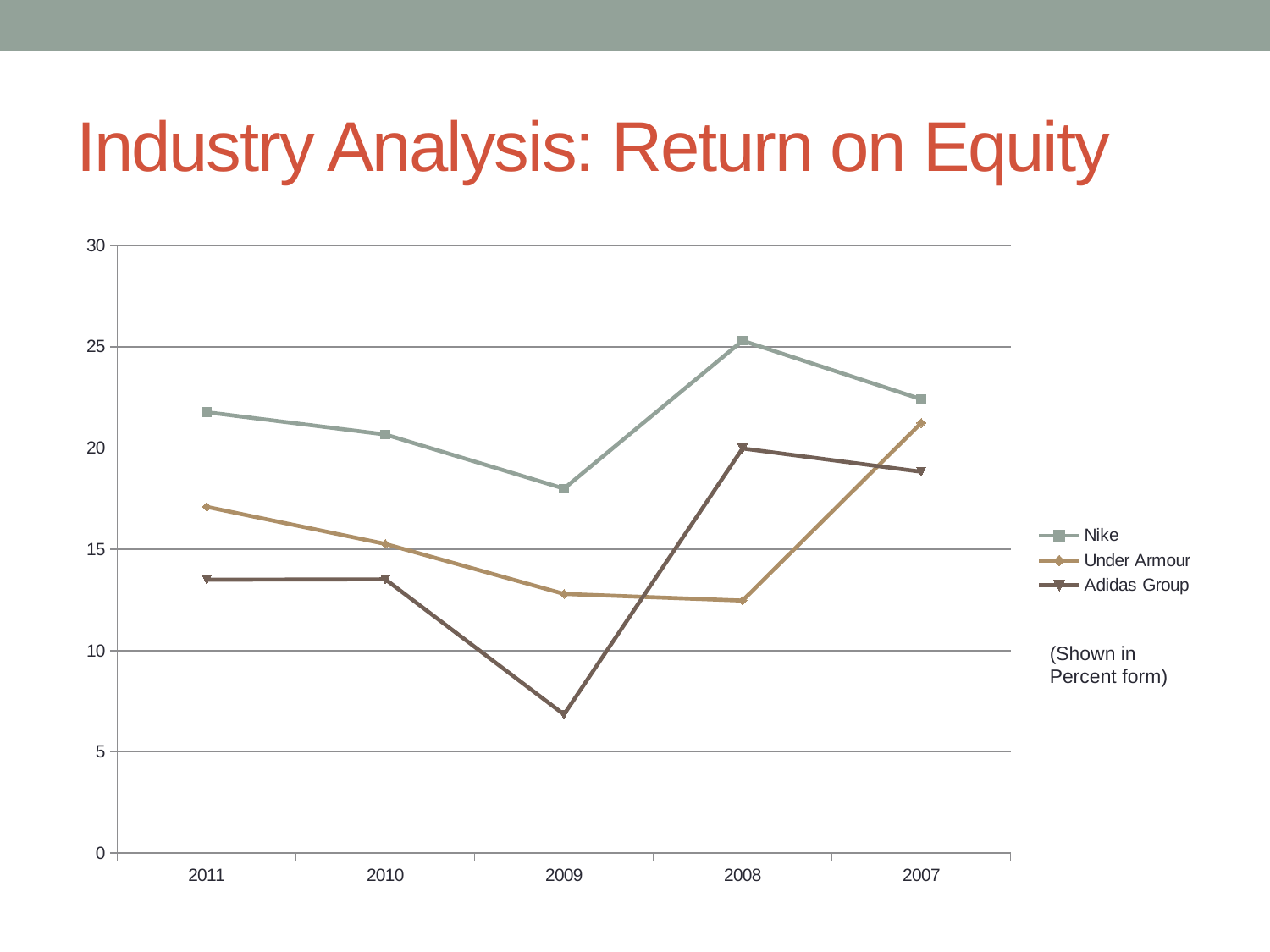
Is the Adidas Group's value for 2009 greater or less than 10? less Does Under Armour's return on equity rise or fall from 2011 to 2009 along the x axis? fall Which company has the higher return on equity in 2011, Nike or Under Armour? Nike What is the title of the slide containing the chart? Industry Analysis: Return on Equity Which company has the higher return on equity in 2007, Under Armour or Adidas Group? Under Armour How many years are shown along the x axis? 5 How many series does the legend list? 3 What kind of chart is shown on the slide? line chart In which year is Nike's return on equity highest? 2008 In which year is Under Armour's return on equity highest? 2007 In which year is the Adidas Group's return on equity lowest? 2009